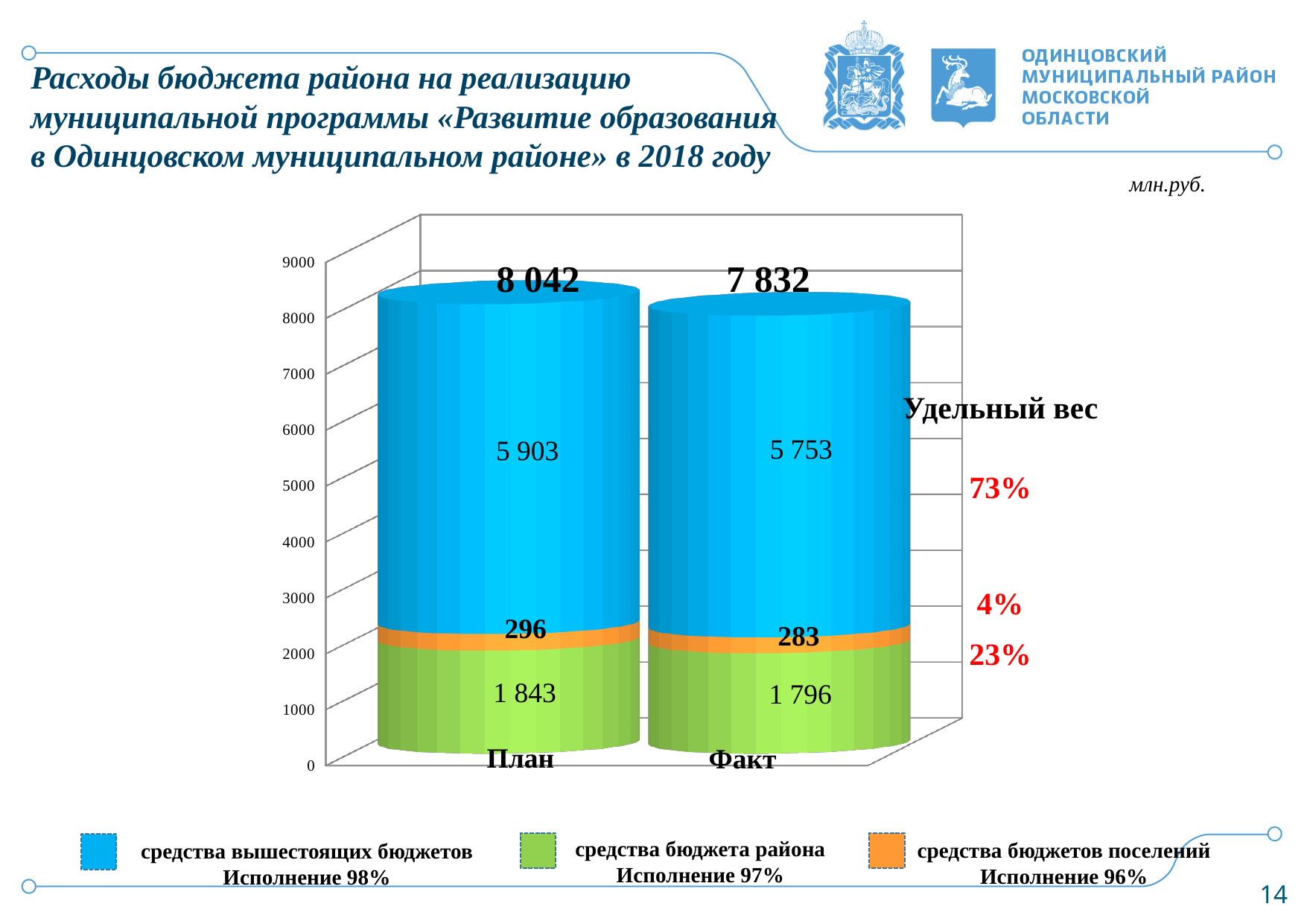
What is the total value shown for the Факт bar? 7 832 What kind of chart is shown on the slide? Stacked bar chart What is the value of средства вышестоящих бюджетов for План? 5 903 Which bar has the larger total, План or Факт? План How many categories are shown on the x axis? 2 What share (Удельный вес) is shown for средства бюджетов поселений? 4% What is the total value shown for the План bar? 8 042 What is the difference between средства бюджета района for План and for Факт? 47 What is the difference between the План and Факт totals? 210 What is the value of средства бюджета района for Факт? 1 796 How many series does the legend list? 3 What is the value of средства бюджетов поселений for Факт? 283